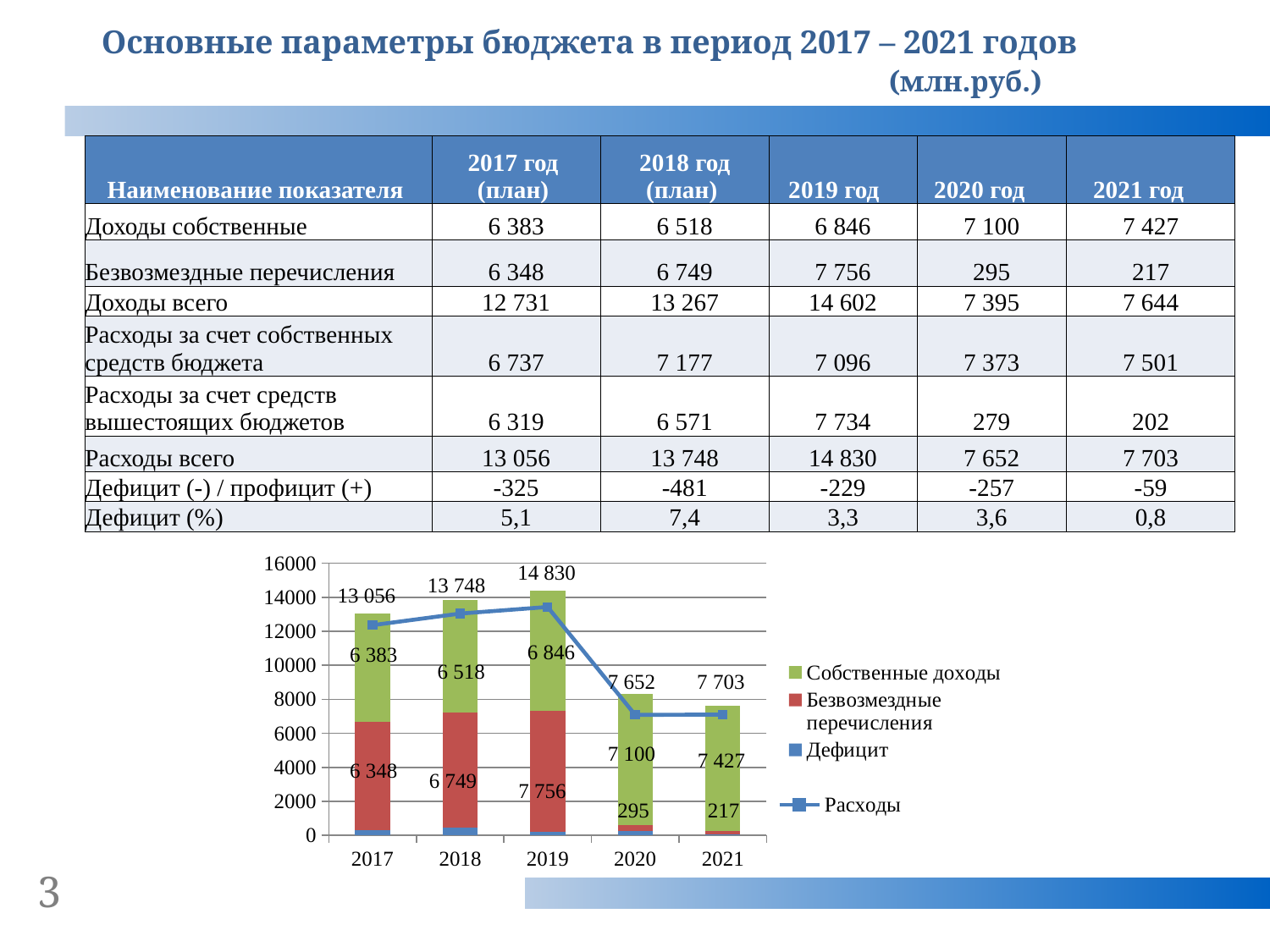
Which is larger in the chart: Безвозмездные перечисления in 2019 or Собственные доходы in 2019? Безвозмездные перечисления in 2019 What is the difference between Собственные доходы in 2021 and in 2017 in the chart? 1 044 What kind of chart is shown on the slide? Stacked bar chart with a line What is the value of the Расходы line for 2020 in the chart? 7 652 Does the Собственные доходы series rise or fall from 2017 to 2021 in the chart? Rise How many series does the chart legend list? 4 Is the value of the Расходы line for 2018 greater or less than 12000? greater What is the value of Собственные доходы for 2019 in the chart? 6 846 How many years are shown on the x axis of the chart? 5 In which year is Безвозмездные перечисления lowest in the chart? 2021 In which year is the Расходы line highest in the chart? 2019 What is the value of Безвозмездные перечисления for 2018 in the chart? 6 749